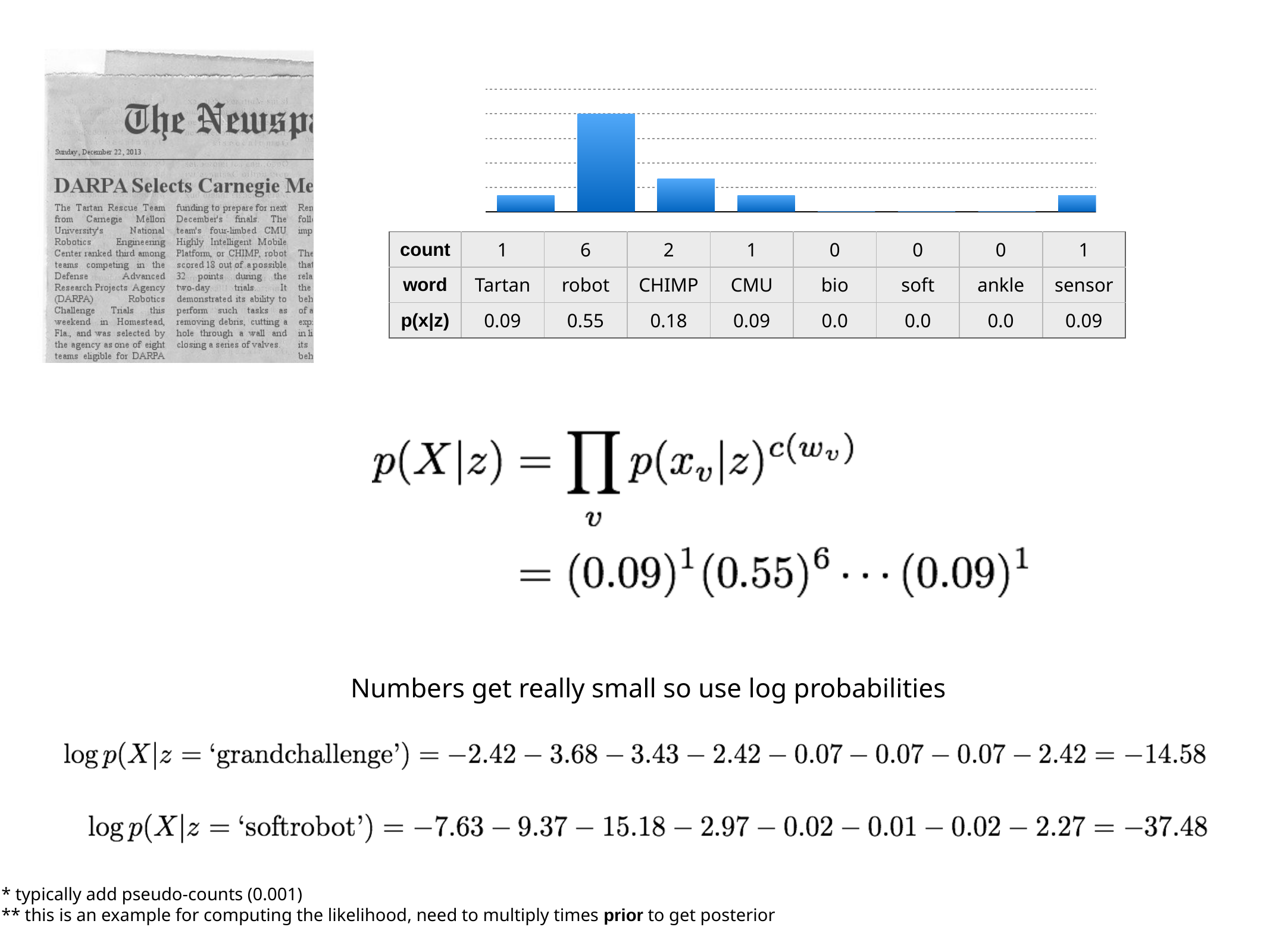
What is p(x|z) for the word robot? 0.55 What is p(x|z) for the word CHIMP? 0.18 How many words (bars) are shown in the chart? 8 What is the count for the word CHIMP? 2 Which has a larger count, Tartan or CHIMP? CHIMP Which word has the highest bar in the chart? robot What is the count for the word robot? 6 What colour are the bars in the chart? blue What is the difference between the count for robot and the count for CHIMP? 4 What kind of chart is shown at the top of the slide? bar chart What is the count for the word sensor? 1 How many words have a count of 0 in the chart? 3